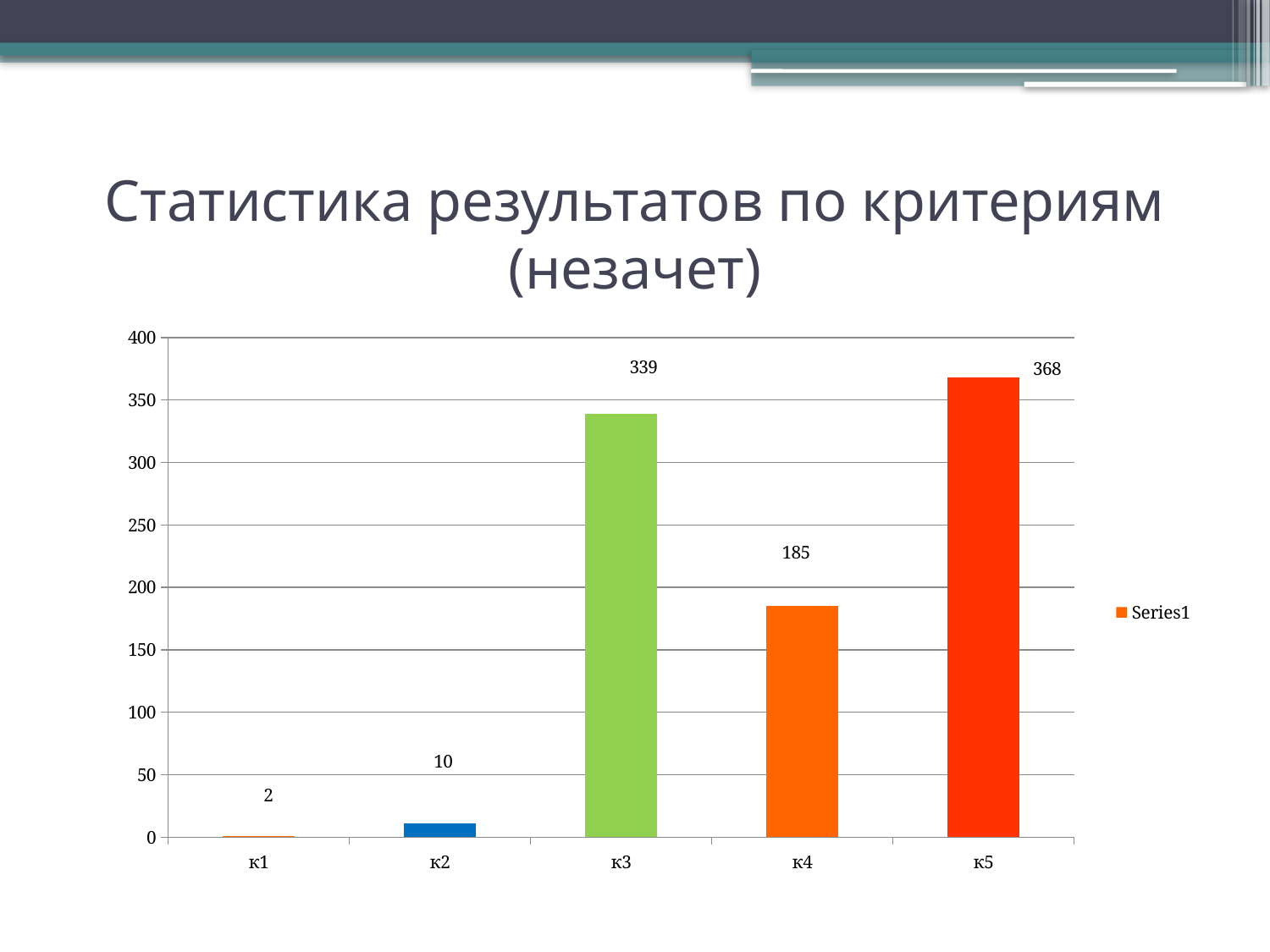
Which category has the highest value? к5 What is the difference between the values for к5 and к3? 29 Which is larger, the value for к3 or the value for к4? к3 Which category has the lowest value? к1 What is the value for к3? 339 Is the value for к4 greater or less than 200? less What kind of chart is shown on the slide? bar chart What is the value for к4? 185 What is the title of the chart on the slide? Статистика результатов по критериям (незачет) How many categories are shown on the x axis? 5 What is the value for к1? 2 What is the difference between the values for к4 and к2? 175